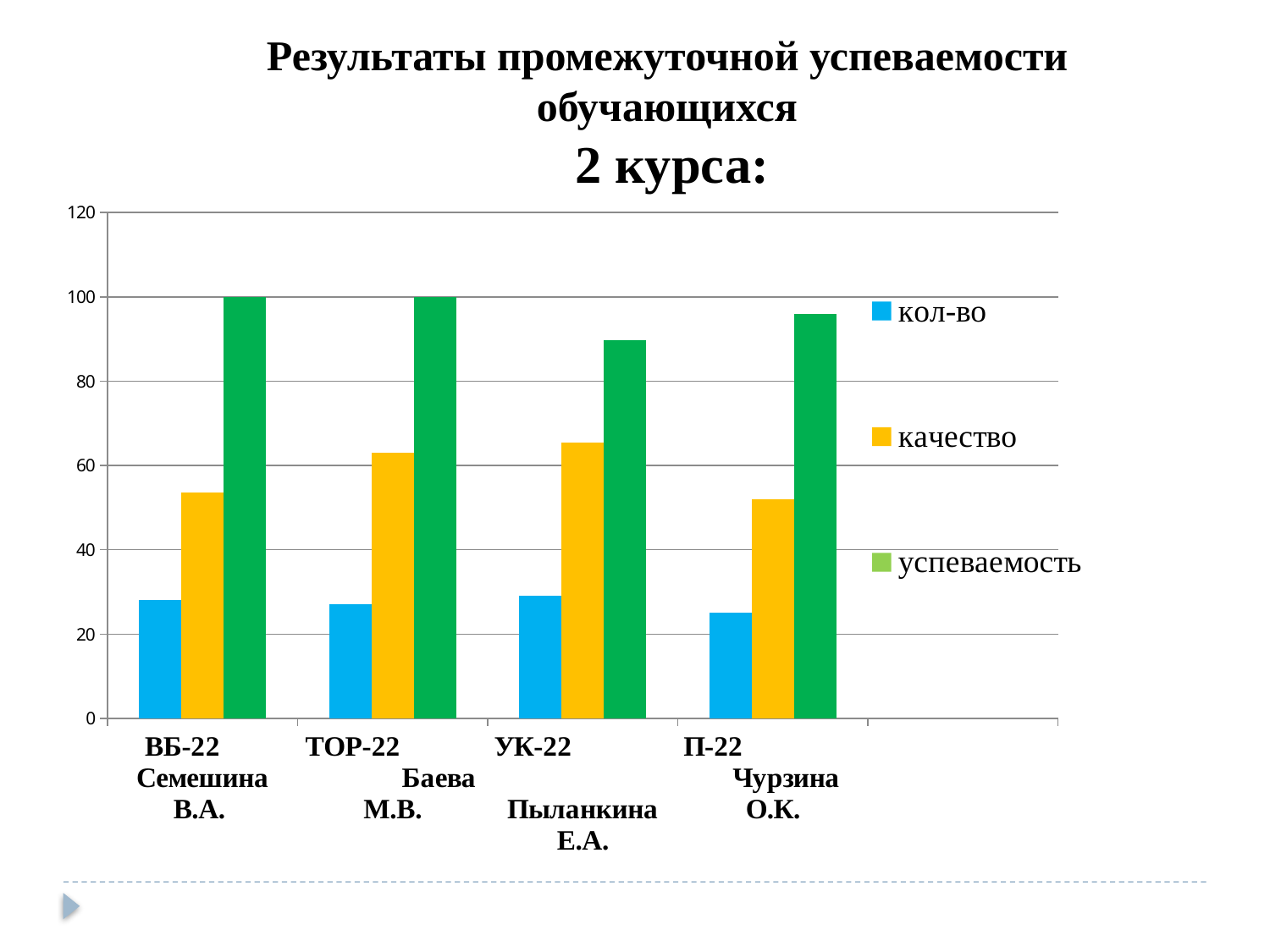
Is the value of качество for ВБ-22 Семешина В.А. greater or less than 60? less What kind of chart is shown on the slide? bar chart What is the value of успеваемость for ТОР-22 Баева М.В.? 100 Which is larger, кол-во for УК-22 Пыланкина Е.А. or кол-во for П-22 Чурзина О.К.? УК-22 Пыланкина Е.А. How many groups (categories) are plotted on the x axis? 4 What are the three series named in the legend? кол-во, качество, успеваемость Is the value of успеваемость for П-22 Чурзина О.К. greater or less than 80? greater How many series does the legend list? 3 What is the value of успеваемость for ВБ-22 Семешина В.А.? 100 Is the value of качество for УК-22 Пыланкина Е.А. greater or less than 60? greater Which group has the lowest успеваемость? УК-22 Пыланкина Е.А.